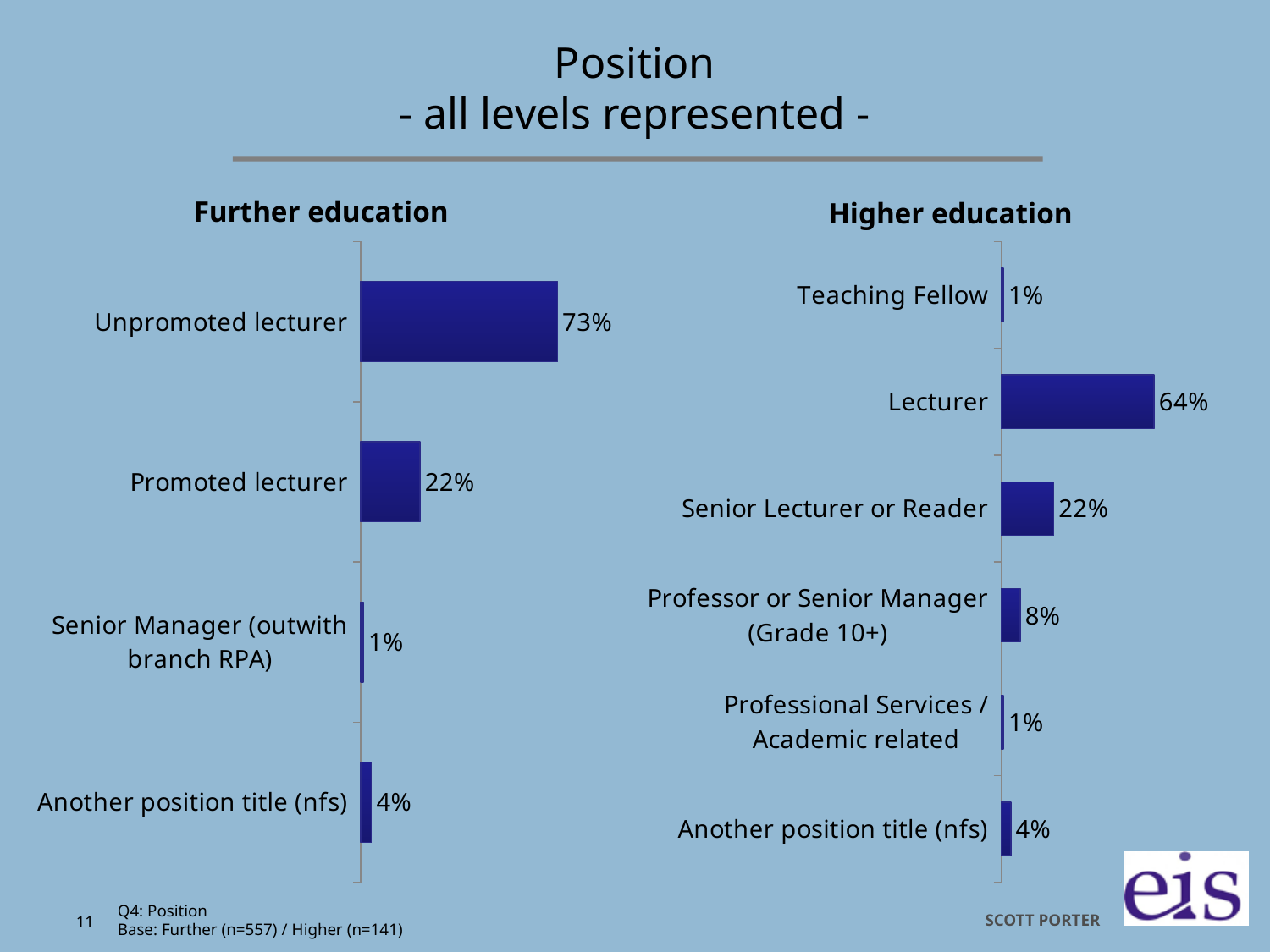
Which is larger: Unpromoted lecturer in the Further education chart or Lecturer in the Higher education chart? Unpromoted lecturer In the Higher education chart, which category has the highest value? Lecturer In the Higher education chart, what is the value for Professor or Senior Manager (Grade 10+)? 8% In the Further education chart, which category has the lowest value? Senior Manager (outwith branch RPA) In the Further education chart, which category has the highest value? Unpromoted lecturer In the Further education chart, what is the difference between Unpromoted lecturer and Promoted lecturer? 51% How many categories does the Further education chart show? 4 In the Higher education chart, what is the value for Senior Lecturer or Reader? 22% In the Higher education chart, what is the difference between Lecturer and Senior Lecturer or Reader? 42% In the Further education chart, what is the value for Unpromoted lecturer? 73% What type of chart is the Further education chart? Bar chart How many categories does the Higher education chart show? 6